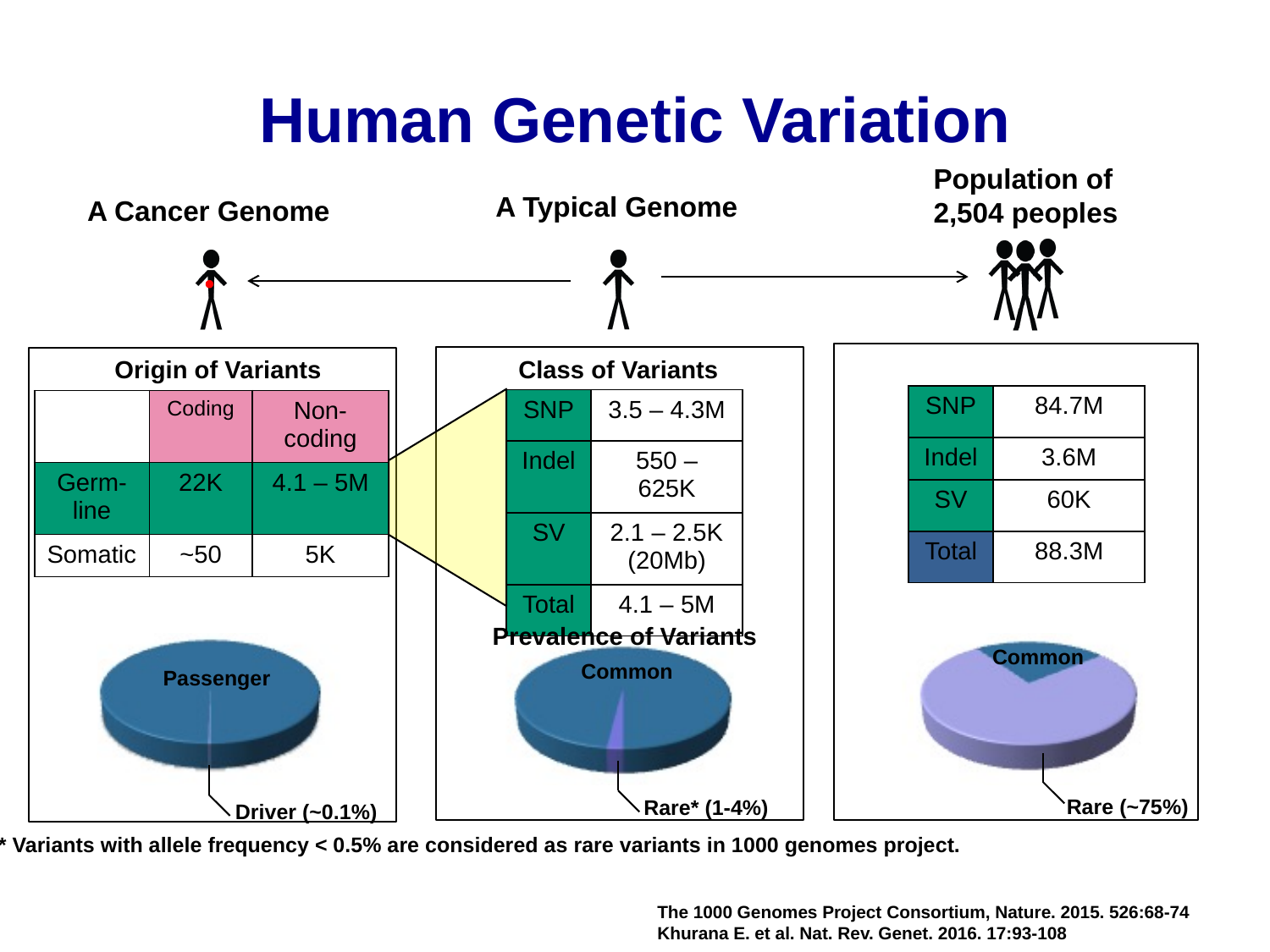
How many pie charts are on the slide? 3 In the 'Prevalence of Variants' pie chart in the 'A Typical Genome' panel, which slice is the smallest? Rare What kind of chart is shown at the bottom of the 'A Cancer Genome' panel? pie chart In the 'Prevalence of Variants' pie chart in the 'A Typical Genome' panel, which slice is larger, Common or Rare? Common In the pie chart in the 'Population of 2,504 peoples' panel, which slice is the smallest? Common In the pie chart in the 'A Cancer Genome' panel, what is the label of the small slice? Driver In the pie chart in the 'A Cancer Genome' panel, which slice is the largest? Passenger In the pie chart in the 'Population of 2,504 peoples' panel, how many slices are there? 2 In the pie chart in the 'A Cancer Genome' panel, which slice is larger, Passenger or Driver? Passenger In the pie chart in the 'A Cancer Genome' panel, how many slices are there? 2 In the pie chart in the 'Population of 2,504 peoples' panel, which slice is larger, Common or Rare? Rare What is the title of the pie chart in the 'A Typical Genome' panel? Prevalence of Variants